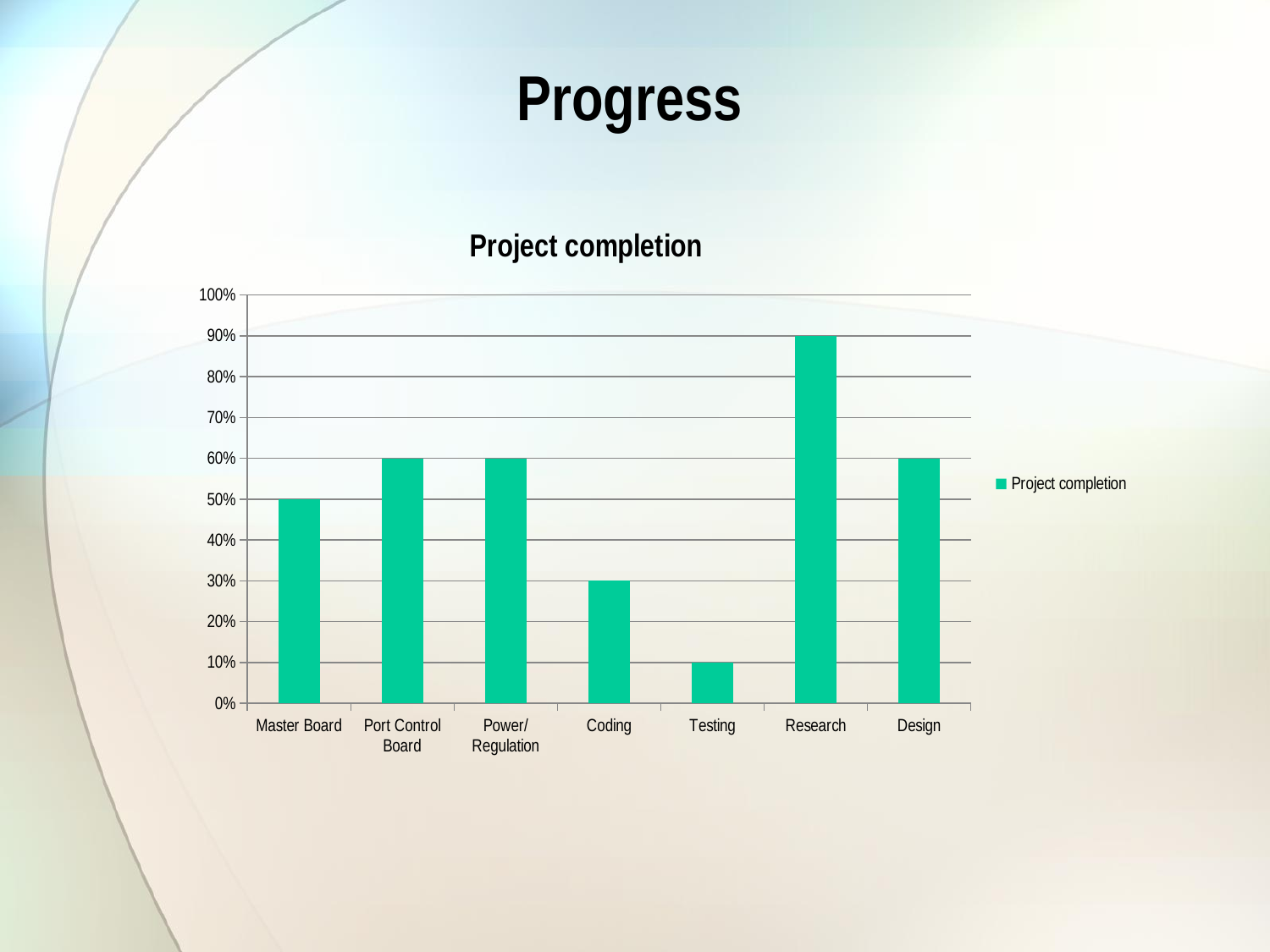
What is the Project completion value for Testing? 10% Which has a higher Project completion, Master Board or Port Control Board? Port Control Board How many series does the legend list? 1 Is the Project completion value for Design greater or less than 50%? greater Which category has the highest Project completion? Research What kind of chart is shown on the slide? bar chart How many categories are shown on the x axis of the chart? 7 What is the Project completion value for Research? 90% Which category has the lowest Project completion? Testing What is the Project completion value for Master Board? 50% What is the difference between the Project completion for Research and for Coding? 60% What is the Project completion value for Coding? 30%